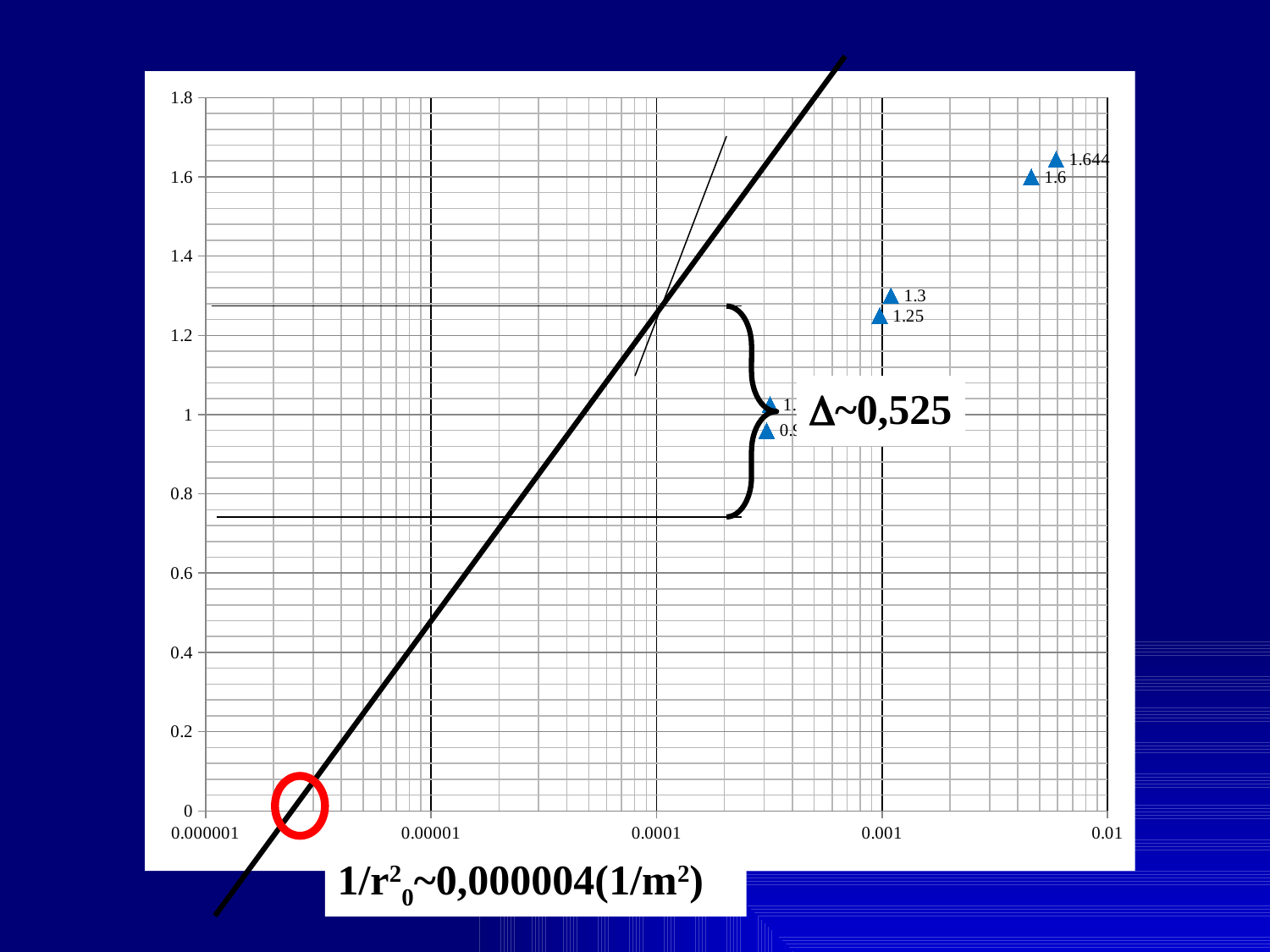
Are the values of the points near x = 0.001 greater or less than 1.2? greater What value is given for Δ in the annotation next to the brace? Δ~0,525 What kind of chart is shown on the slide? scatter chart How many data points (triangles) are plotted on the chart? 6 What is the highest data label shown on the chart? 1.644 Do the plotted values rise or fall as x increases along the axis? rise What is the difference between the two labeled points near x = 0.005 (1.644 and 1.6)? 0.044 Which is larger, the point labeled 1.644 or the point labeled 1.3? 1.644 Are the values of the points near x = 0.0003 greater or less than 1.2? less What value is given for 1/r²₀ in the annotation below the x axis? 0,000004(1/m²) What is the difference between the two labeled points near x = 0.001 (1.3 and 1.25)? 0.05 What is the lowest data label shown among the points near x = 0.001? 1.25